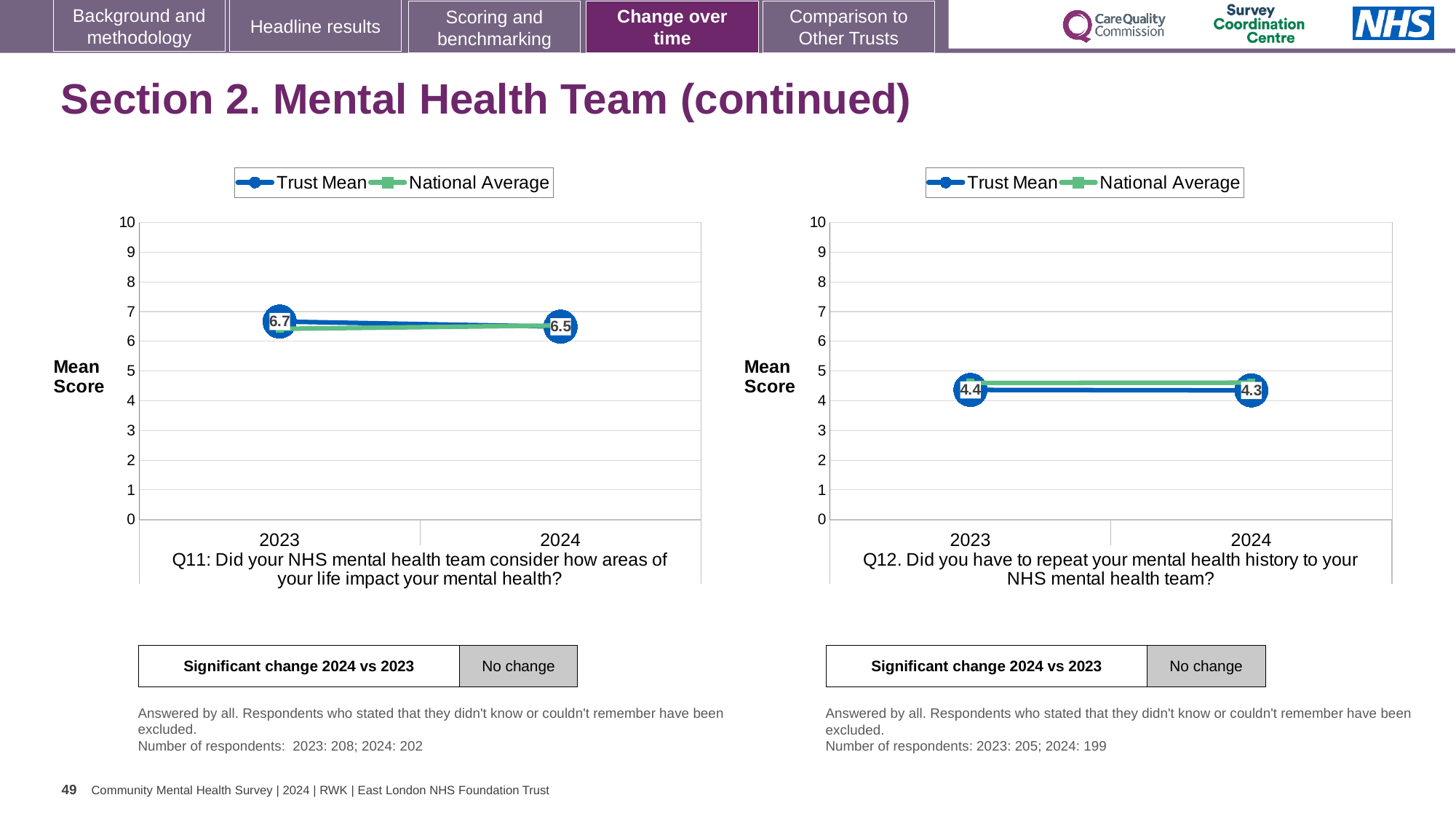
In the Q11 chart on the left, which year has the higher Trust Mean, 2023 or 2024? 2023 How many years are shown on the x axis of the Q12 chart on the right? 2 In the Q11 chart on the left, by how much did the Trust Mean change from 2023 to 2024? 0.2 In the Q11 chart on the left, what is the Trust Mean for 2024? 6.5 In the Q12 chart on the right, what is the Trust Mean for 2024? 4.3 What does the 'Significant change 2024 vs 2023' box below the Q11 chart on the left say? No change In the Q12 chart on the right, what is the Trust Mean for 2023? 4.4 What kind of chart is the Q12 chart on the right? line chart In the Q12 chart on the right, is the National Average for 2024 greater or less than 4? greater In the Q11 chart on the left, what is the Trust Mean for 2023? 6.7 How many series does the legend of the Q11 chart on the left list? 2 In the Q12 chart on the right, does the Trust Mean rise or fall from 2023 to 2024? fall